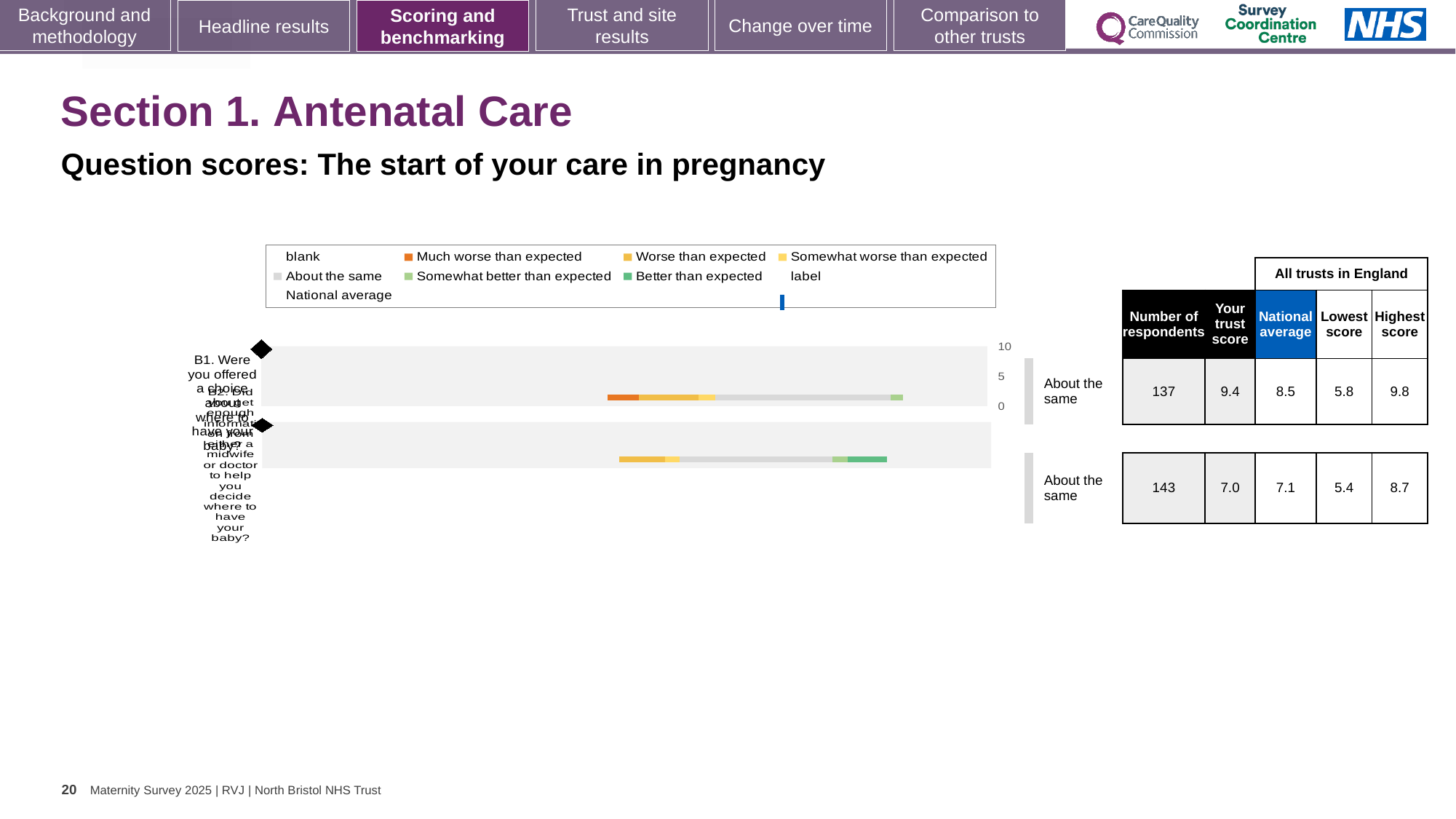
What is the difference between the highest and lowest scores for question B1? 4.0 What is the difference between the trust score and the national average for question B1? 0.9 What is the trust score for question B1? 9.4 What is the national average for question B1? 8.5 Which question has the higher trust score, B1 or B2? B1 For question B1, which is larger: the trust score or the national average? the trust score What kind of chart is shown on the slide? bar chart What is the highest score across all trusts in England for question B2? 8.7 What is the number of respondents for question B2? 143 What benchmark category is shown for question B2? About the same What is the lowest score across all trusts in England for question B1? 5.8 How many questions (rows) are plotted in the chart? 2